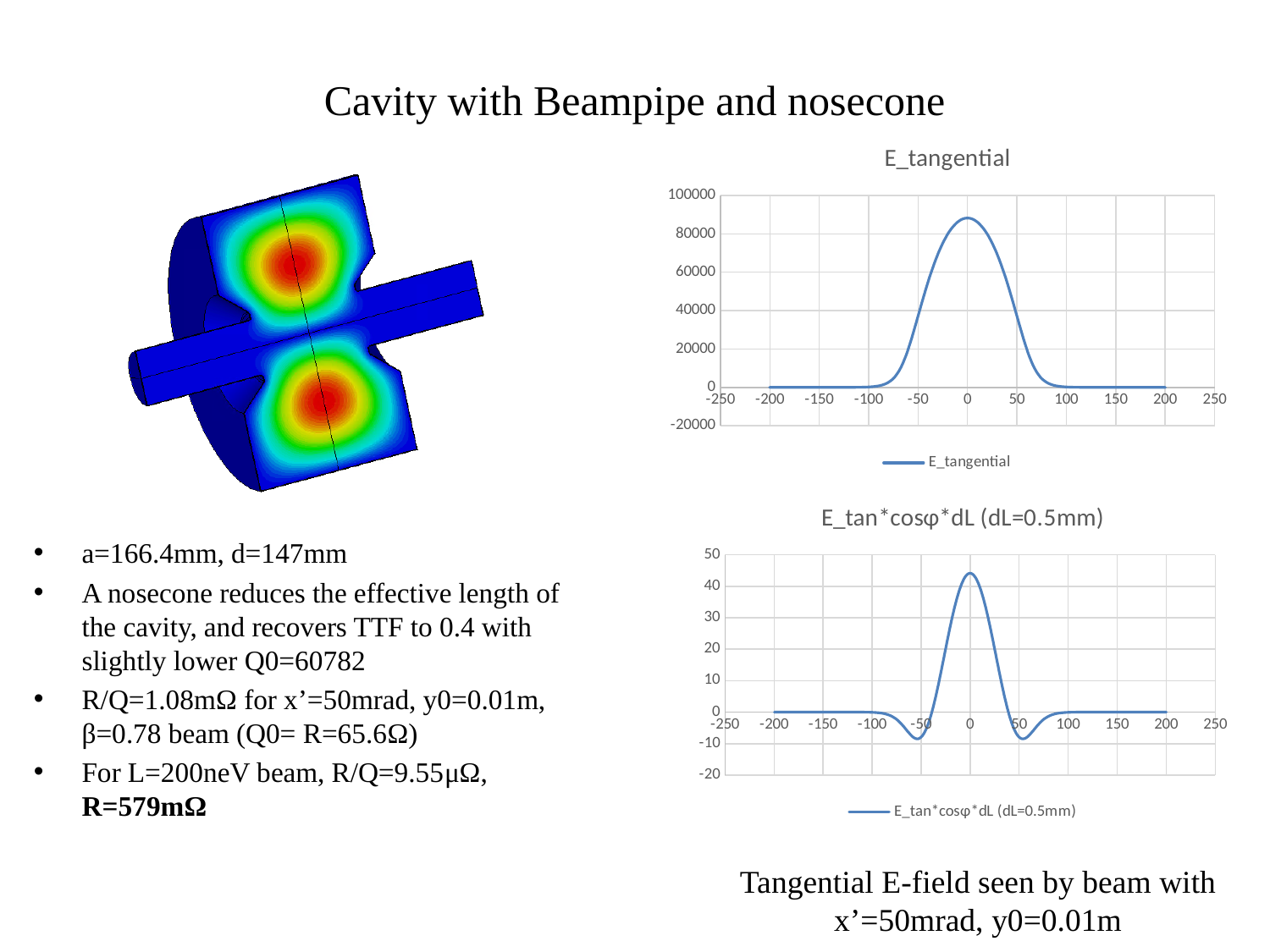
How many series does the legend of the E_tan*cosφ*dL (dL=0.5mm) chart list? 1 In the E_tangential chart, is the value at x=100 greater or less than 20000? less What kind of chart is the E_tan*cosφ*dL (dL=0.5mm) chart at the bottom right? line chart In the E_tan*cosφ*dL (dL=0.5mm) chart, is the value at x=-50 greater or less than 0? less What is the title of the lower chart on the right side of the slide? E_tan*cosφ*dL (dL=0.5mm) What kind of chart is the E_tangential chart at the top right? line chart In the E_tangential chart, does the curve rise or fall as x goes from -100 to 0? rise In the E_tangential chart, is the value at x=-200 greater or less than 20000? less How many series does the legend of the E_tangential chart list? 1 In the E_tangential chart, does the curve rise or fall as x goes from 0 to 100? fall